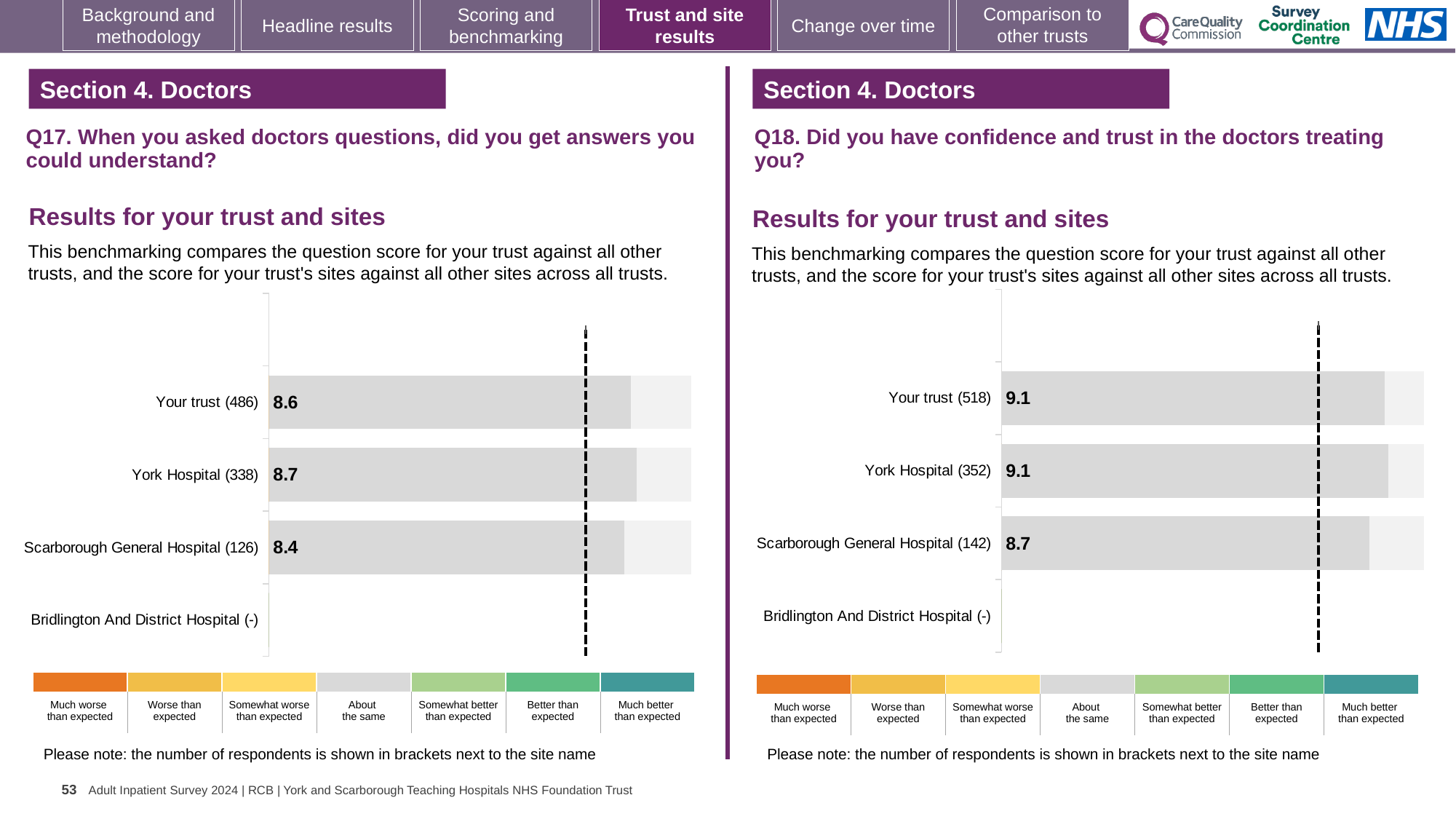
In the Q17 chart on the left, what is the score for Your trust? 8.6 In the Q18 chart on the right, is the York Hospital score larger or smaller than the Scarborough General Hospital score? larger In the Q17 chart on the left, which site has the highest score? York Hospital In the Q18 chart on the right, what is the score for Your trust? 9.1 What kind of chart is used in the Q18 chart on the right? Bar chart In the Q18 chart on the right, what is the difference between the Your trust score and the Scarborough General Hospital score? 0.4 In the Q18 chart on the right, which site has the lowest score among those with a score shown? Scarborough General Hospital In the Q17 chart on the left, what is the score for Scarborough General Hospital? 8.4 How many site rows (including Your trust) are listed in the Q17 chart on the left? 4 In the Q17 chart on the left, how many respondents are shown for Your trust? 486 In the Q18 chart on the right, what is the score for Scarborough General Hospital? 8.7 In the Q17 chart on the left, what is the difference between the York Hospital score and the Scarborough General Hospital score? 0.3